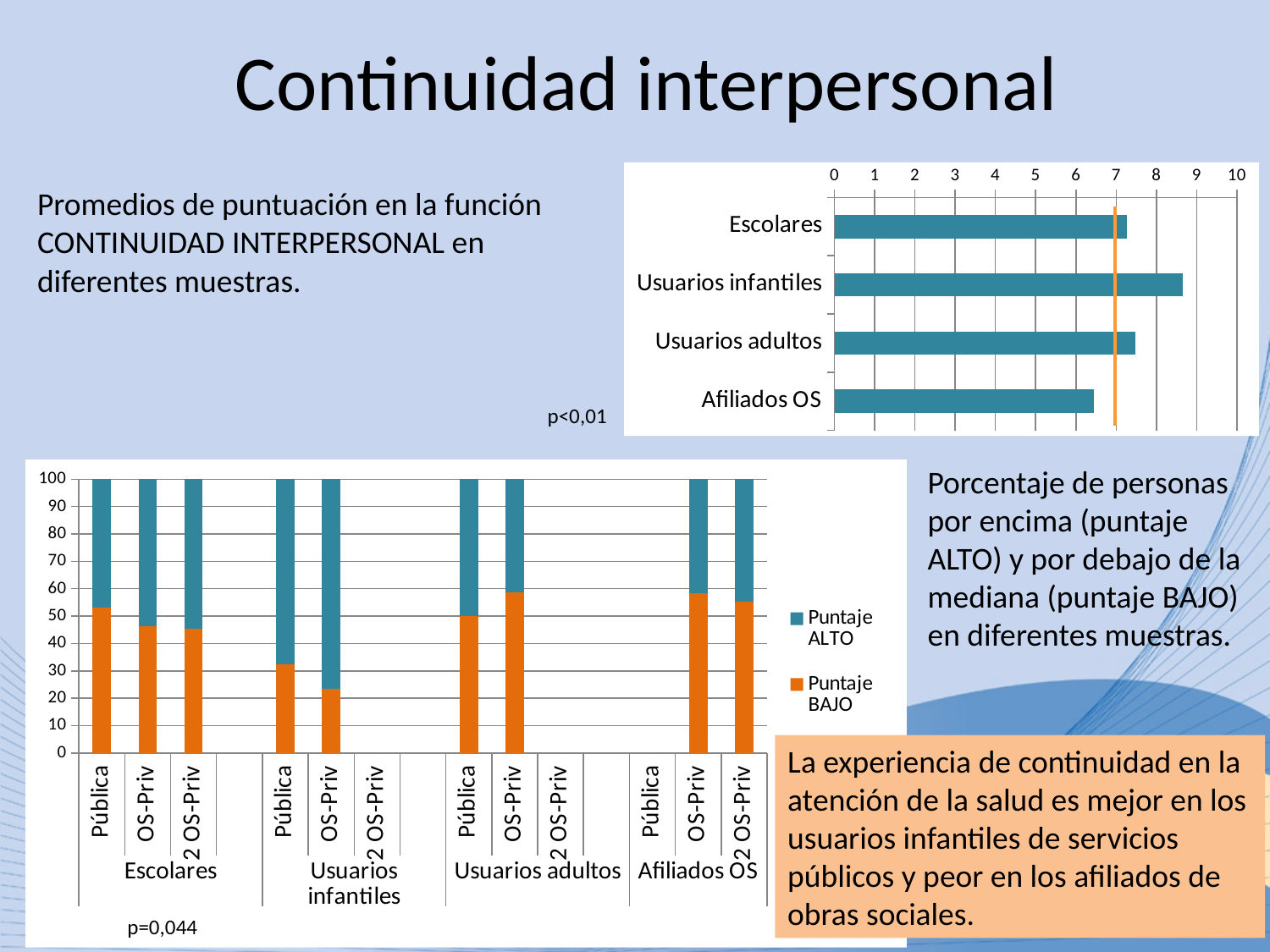
How many series does the legend of the bottom-left chart list? 2 In the top-right bar chart, which is larger, the value for Usuarios infantiles or the value for Usuarios adultos? Usuarios infantiles In the top-right bar chart, which category has the highest value? Usuarios infantiles How many categories are shown in the top-right bar chart? 4 In the top-right bar chart, is the value for Afiliados OS greater or less than 7? less What kind of chart is the top-right chart? bar chart In the bottom-left stacked bar chart, which series is shown in orange? Puntaje BAJO In the top-right bar chart, is the value for Usuarios infantiles greater or less than 8? greater In the top-right bar chart, which category has the lowest value? Afiliados OS In the bottom-left stacked bar chart, is the Puntaje BAJO value for Escolares Pública greater or less than 50? greater